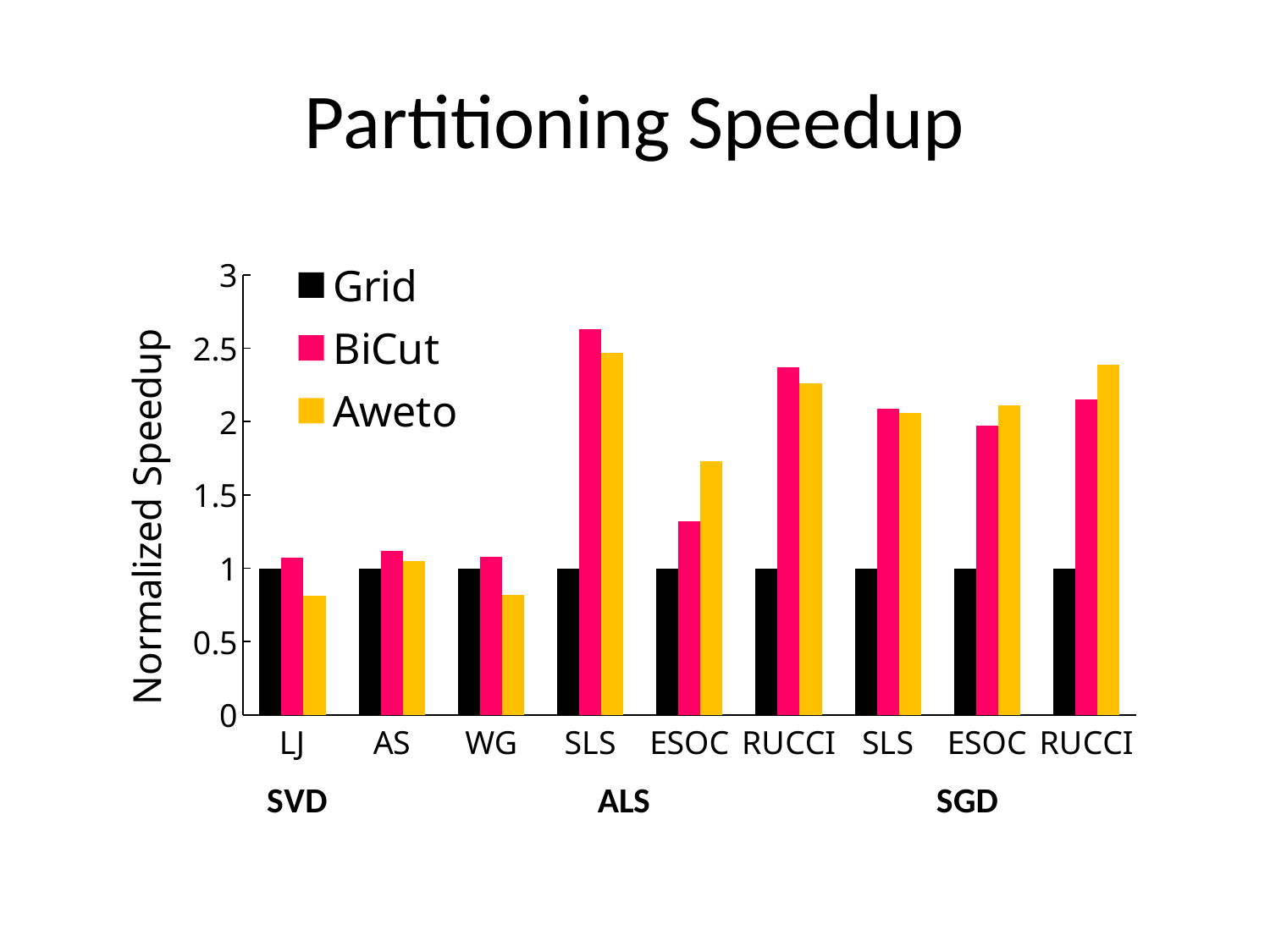
For ESOC under ALS, which is larger, BiCut or Aweto? Aweto What is the title of the chart? Partitioning Speedup What is the label on the y axis? Normalized Speedup Is the Aweto value for LJ greater or less than 1? less For SLS under ALS, which is larger, BiCut or Aweto? BiCut Is the Aweto value for ESOC under ALS greater or less than 1.5? greater Which category has the highest BiCut bar? SLS (ALS) How many series does the legend list? 3 Is the BiCut value for SLS under ALS greater or less than 2.5? greater What kind of chart is shown on the slide? bar chart How many categories are shown along the x axis? 9 What is the Grid value for LJ? 1